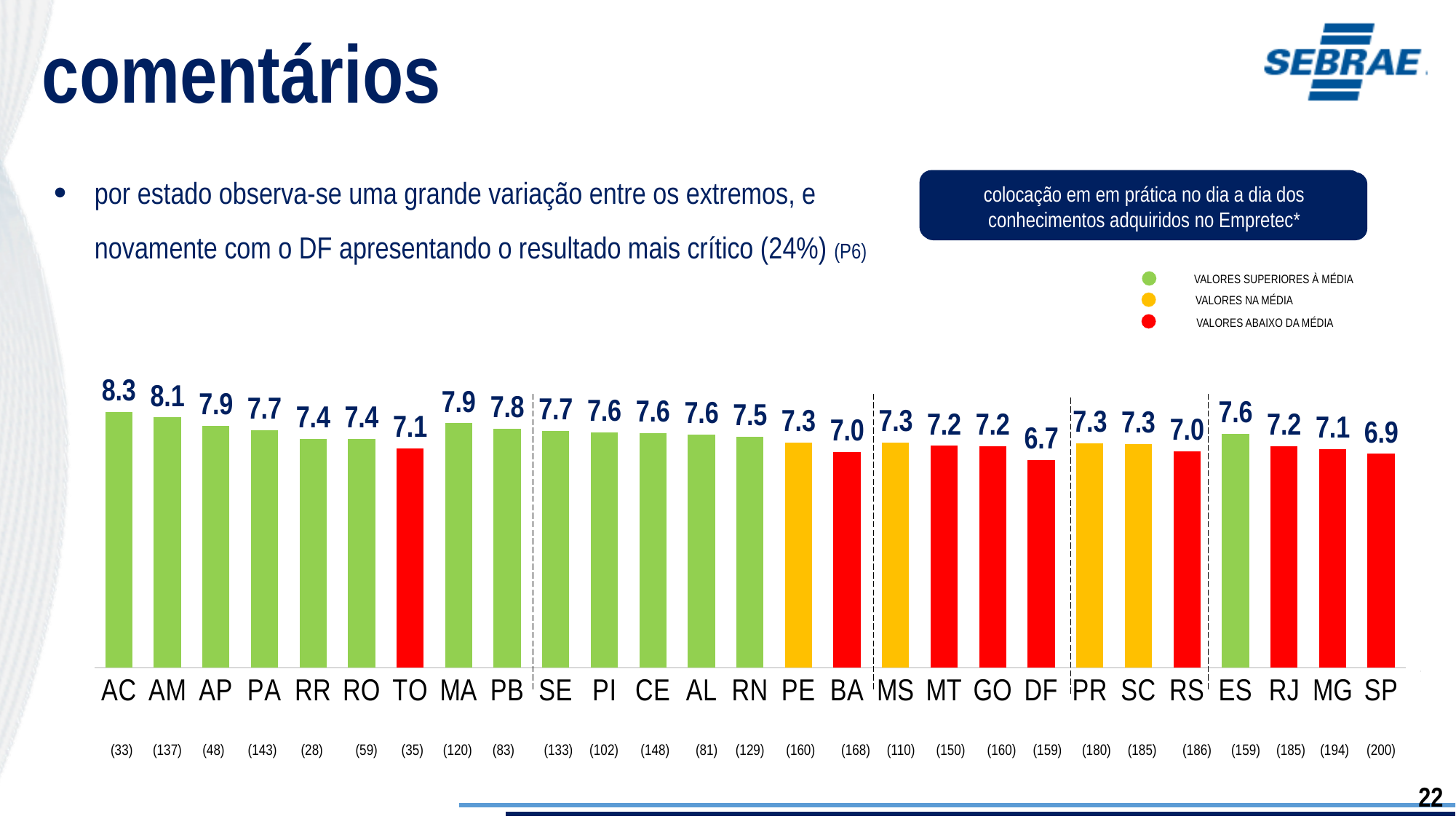
Which has a larger value, MA or BA? MA Which state has the lowest value in the chart? DF How many states (bars) are shown in the chart? 27 What is the value shown for SP? 6.9 What is the difference between the values for AM and SP? 1.2 Which state has the highest value in the chart? AC Which has a larger value, PB or RS? PB What is the value shown for AC? 8.3 What type of chart is shown on the slide? Bar chart What is the value shown for DF? 6.7 What colour is the bar for DF? Red What is the difference between the values for AC and DF? 1.6